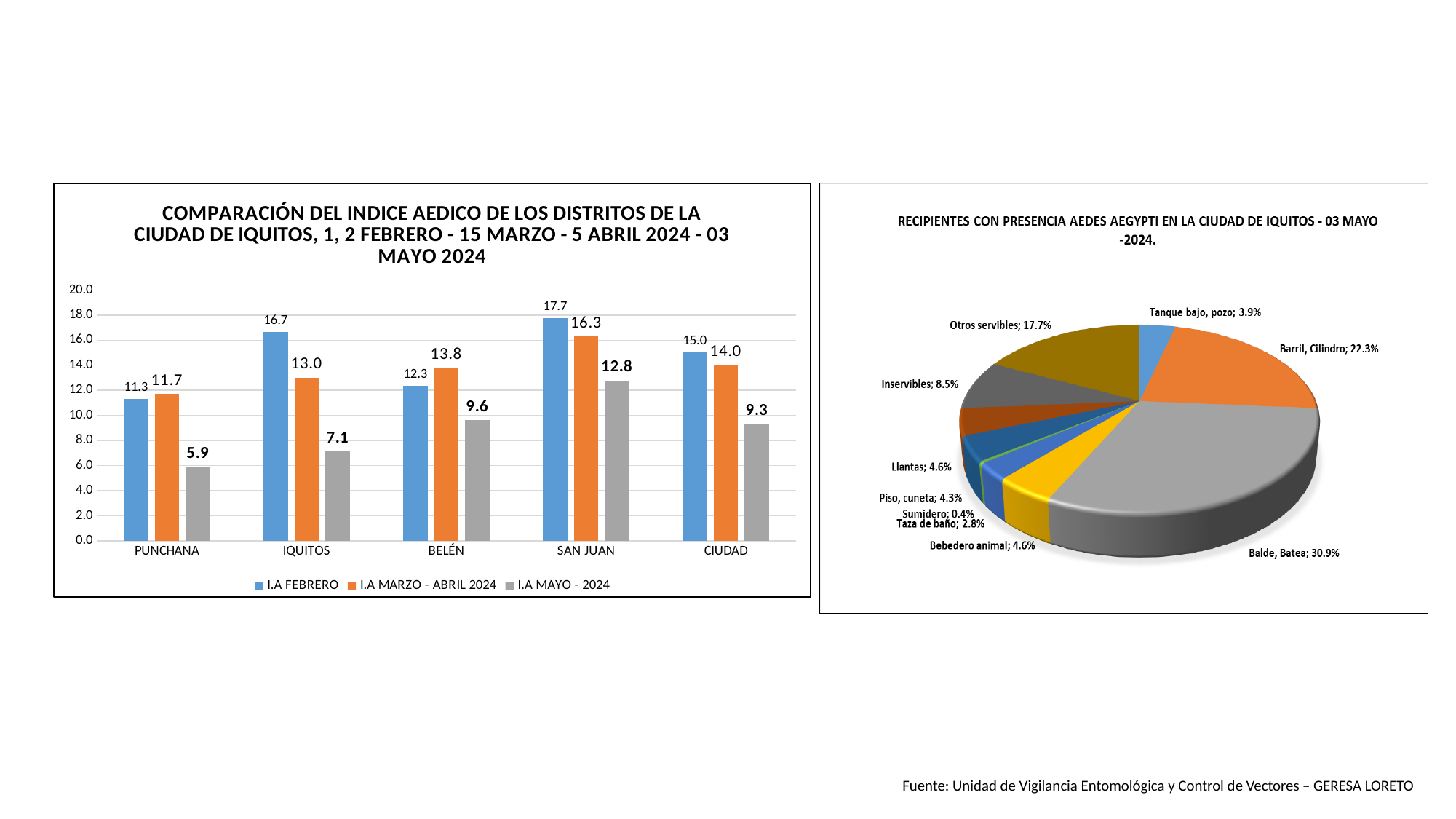
How many series does the legend of the bar chart on the left list? 3 In the bar chart on the left, what is the difference between the I.A FEBRERO and I.A MAYO - 2024 values for IQUITOS? 9.6 In the bar chart on the left, what is the I.A MARZO - ABRIL 2024 value for BELÉN? 13.8 In the bar chart on the left, what is the I.A MAYO - 2024 value for PUNCHANA? 5.9 In the pie chart on the right, which container type has the smallest share? Sumidero In the bar chart on the left, which is larger for CIUDAD: the I.A FEBRERO value or the I.A MARZO - ABRIL 2024 value? I.A FEBRERO What kind of chart is the chart on the right? Pie chart In the bar chart on the left, which district has the lowest I.A MAYO - 2024 value? PUNCHANA How many districts are shown on the x axis of the bar chart on the left? 5 In the pie chart on the right, what share does Balde, Batea have? 30.9% In the bar chart on the left, which district has the highest I.A FEBRERO value? SAN JUAN In the bar chart on the left, what is the I.A FEBRERO value for SAN JUAN? 17.7